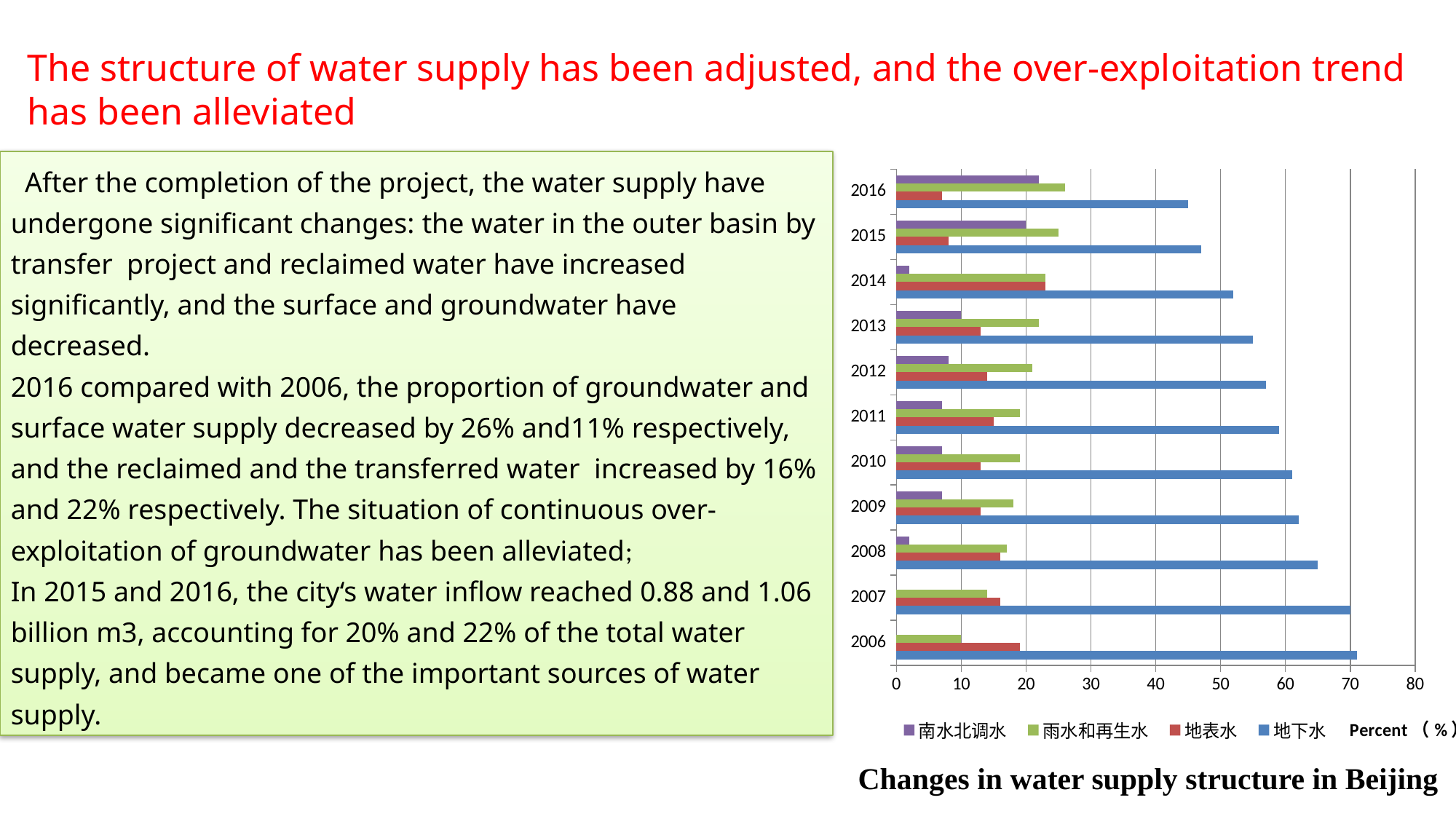
What is the caption below the chart? Changes in water supply structure in Beijing Is the value for 地下水 in 2006 greater or less than 60? greater Which year has the lowest value for 雨水和再生水? 2006 Is the value for 地下水 in 2016 greater or less than 50? less Which year has the highest value for 地下水? 2006 What kind of chart is shown on the slide? Bar chart How many series does the chart legend list? 4 How many years (categories) are shown on the chart? 11 In 2006, which is larger: 地表水 or 雨水和再生水? 地表水 Is the value for 南水北调水 in 2014 greater or less than 10? less Does the value for 地下水 rise or fall from 2006 to 2016? Fall Which year has the lowest value for 地下水? 2016